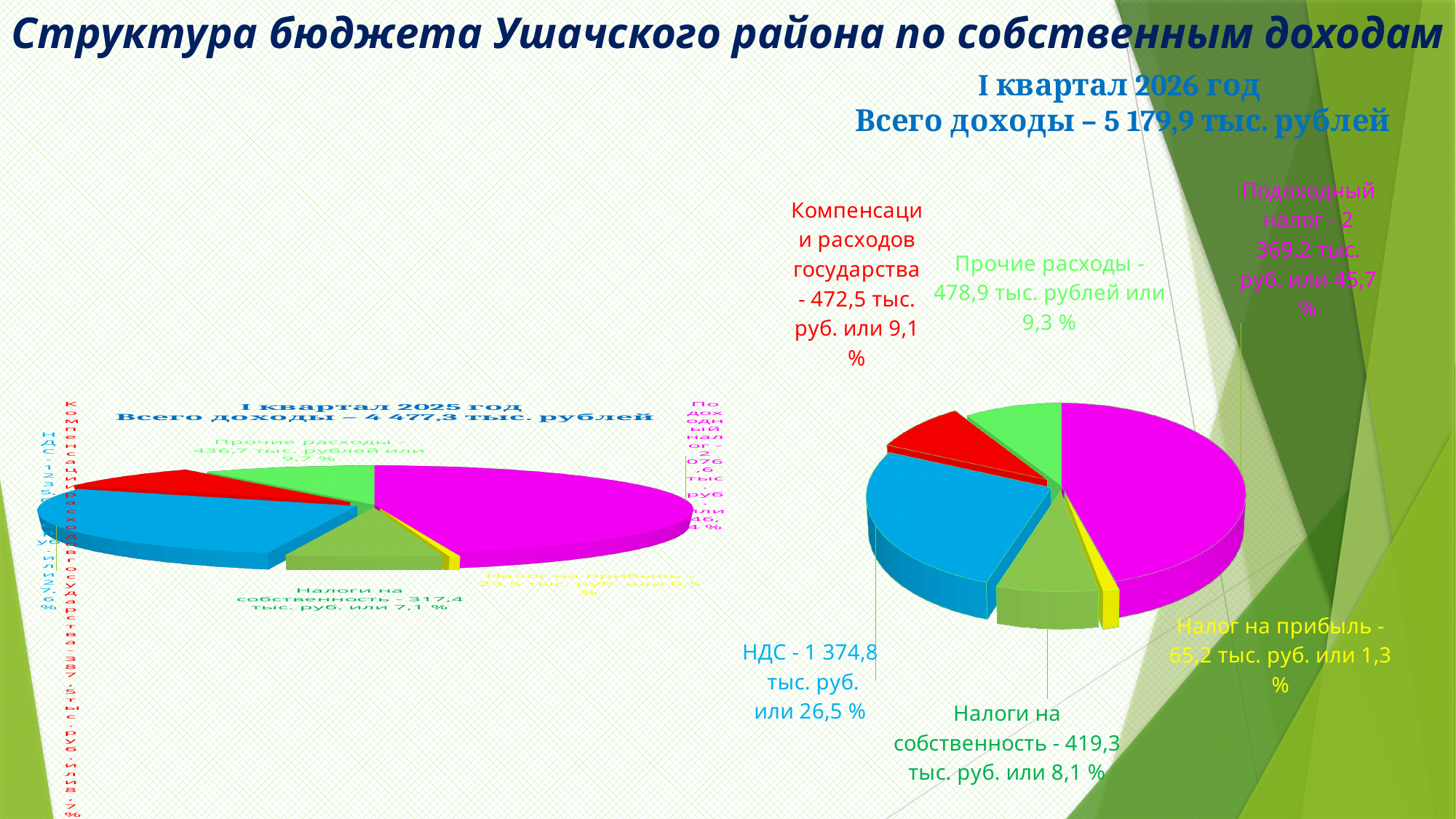
What total income is stated for I квартал 2026 год? 5 179,9 тыс. рублей On the right pie chart (I квартал 2026 год), what share does Компенсации расходов государства account for? 9,1 % On the right pie chart (I квартал 2026 год), which category has the smallest slice? Налог на прибыль On the right pie chart (I квартал 2026 год), what share of the total does НДС account for? 26,5 % On the right pie chart (I квартал 2026 год), which category has the largest slice? Подоходный налог On the right pie chart (I квартал 2026 год), what is the difference in percentage points between Подоходный налог (45,7 %) and НДС (26,5 %)? 19,2 percentage points On the right pie chart (I квартал 2026 год), what is the value for Налоги на собственность? 419,3 тыс. руб. On the left pie chart (I квартал 2025 год), what share does Прочие расходы account for? 9,7 % On the right pie chart (I квартал 2026 год), which is larger: Прочие расходы or Налог на прибыль? Прочие расходы What type of chart is used on this slide? Pie chart On the right pie chart (I квартал 2026 год), what is the value for Подоходный налог? 2 369,2 тыс. руб. How many slices does the right pie chart (I квартал 2026 год) have? 6